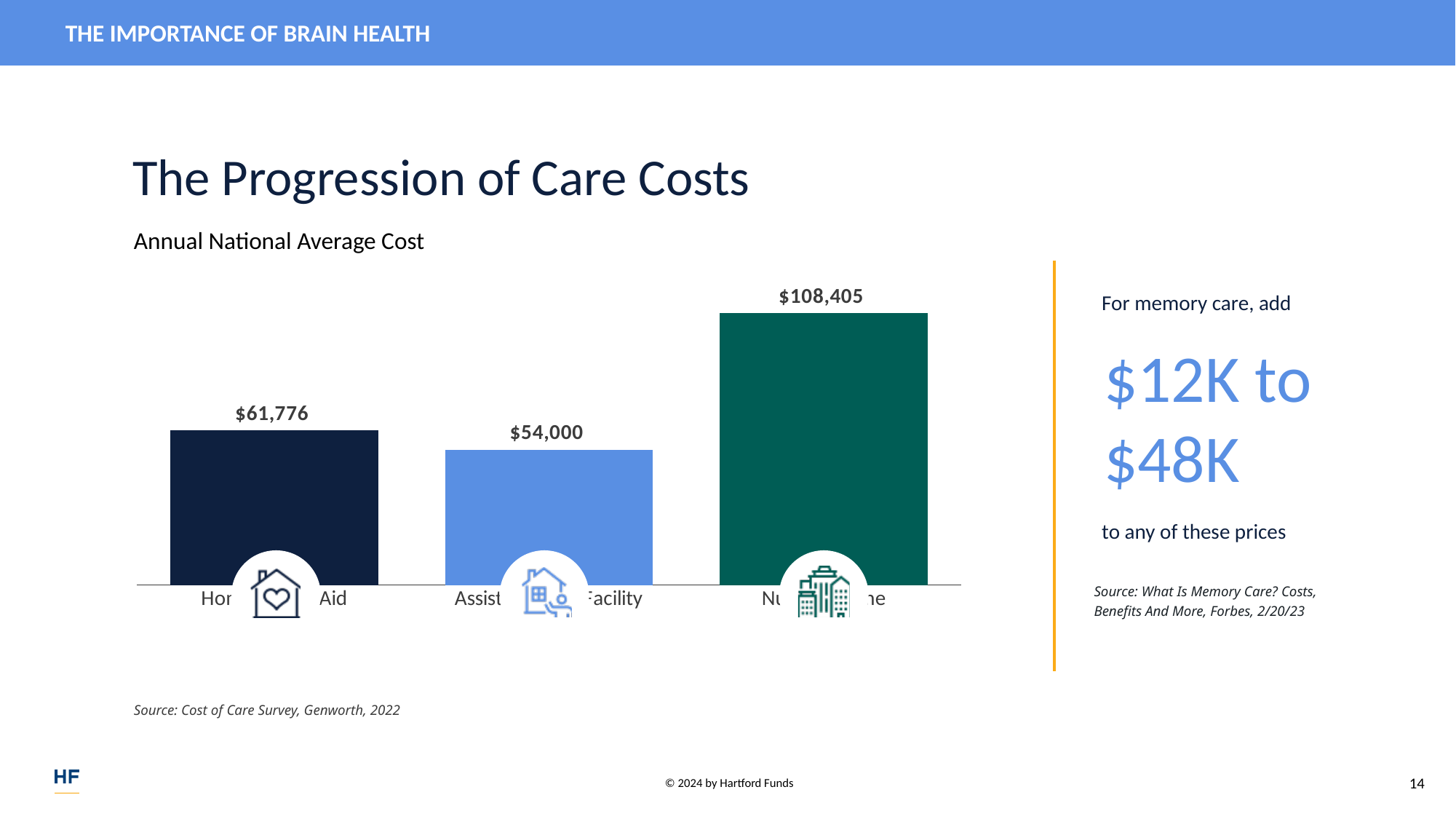
What is the difference between the right-most bar ($108,405) and the left-most bar ($61,776)? $46,629 What kind of chart is shown on the slide? Bar chart How many bars are plotted in the chart? 3 What is the annual national average cost shown for the left-most (dark navy) bar? $61,776 Which bar shows the lowest annual national average cost? The middle (light blue) bar, $54,000 What is the annual national average cost shown for the right-most (dark green) bar? $108,405 What is the subtitle printed above the chart? Annual National Average Cost What is the difference between the right-most bar ($108,405) and the middle bar ($54,000)? $54,405 Which is larger, the value of the left-most bar or the middle bar? The left-most bar ($61,776) What is the difference between the left-most bar ($61,776) and the middle bar ($54,000)? $7,776 What is the annual national average cost shown for the middle (light blue) bar? $54,000 Which bar shows the highest annual national average cost? The right-most (dark green) bar, $108,405